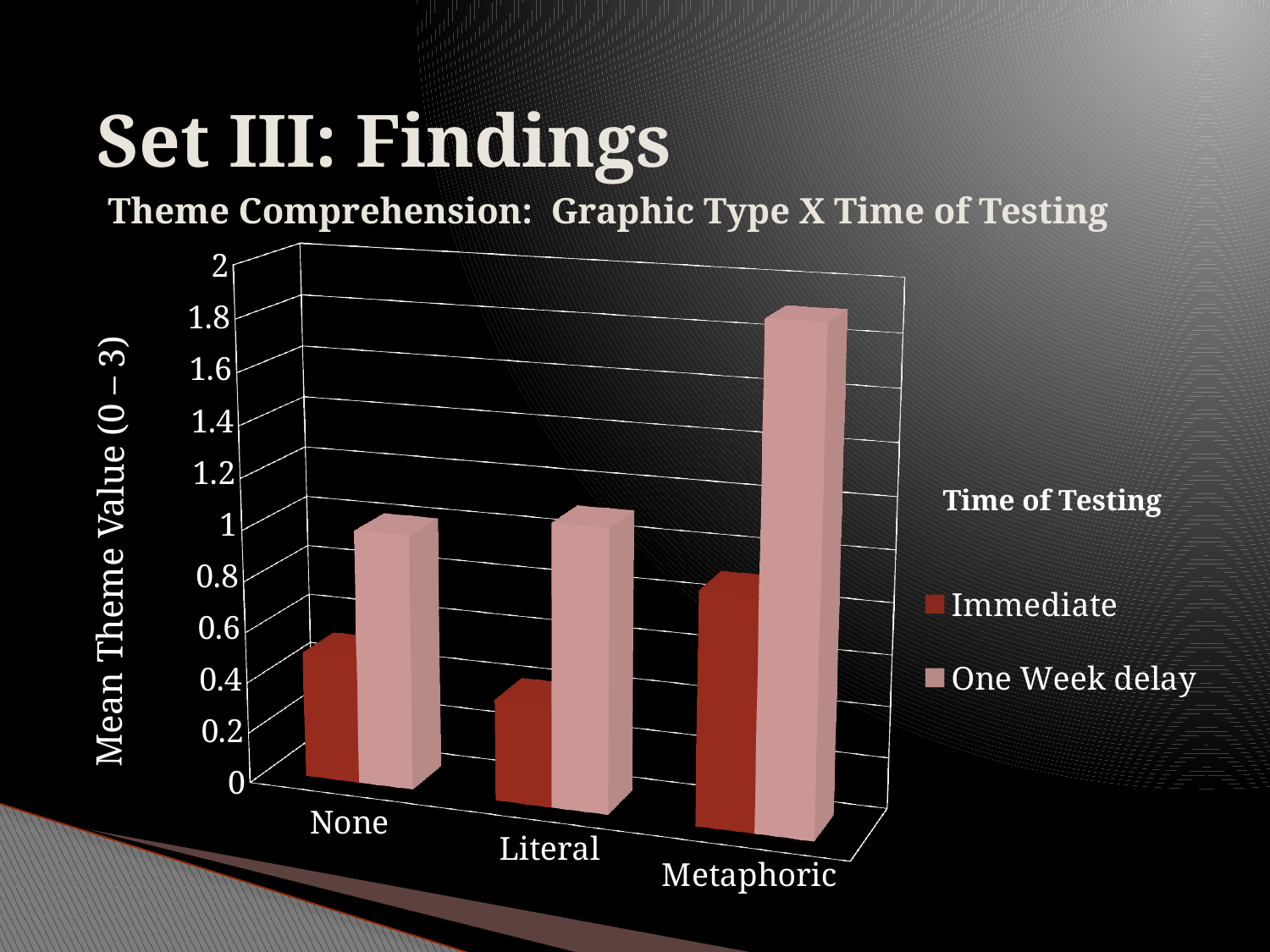
Is the Immediate value for Literal greater or less than 0.6? less What is the label of the y axis? Mean Theme Value (0 – 3) For the Metaphoric category, which is larger, the Immediate value or the One Week delay value? One Week delay Which graphic type has the lowest Immediate value? Literal What kind of chart is shown on the slide? bar chart How many series does the legend list? 2 Which is larger, the Immediate value for Metaphoric or the Immediate value for None? Metaphoric How many graphic type categories are shown on the x axis? 3 Which graphic type has the highest One Week delay value? Metaphoric Is the One Week delay value for Metaphoric greater or less than 1.6? greater What is the title of the legend? Time of Testing Is the One Week delay value for None greater or less than 1.4? less